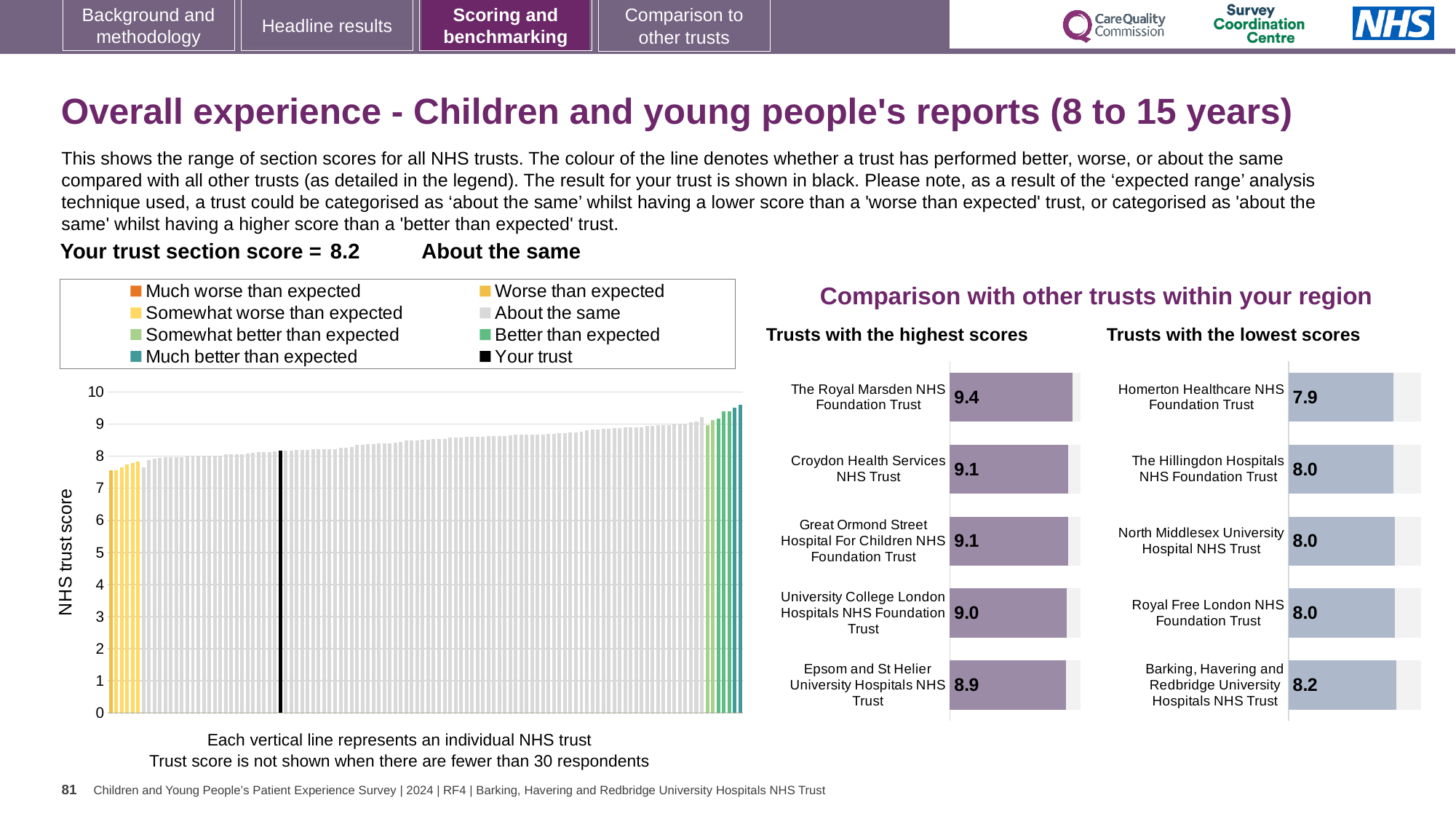
In the 'Trusts with the lowest scores' chart, what is the difference between the scores of Barking, Havering and Redbridge University Hospitals NHS Trust and Homerton Healthcare NHS Foundation Trust? 0.3 In the large chart on the left, is the value of the highest bar greater or less than 9? greater In the large chart on the left, do the trust scores rise or fall from left to right? Rise What kind of chart is the large chart on the left showing NHS trust scores? Bar chart In the 'Trusts with the highest scores' chart, how many trusts are shown? 5 In the 'Trusts with the highest scores' chart, which trust has the lowest score? Epsom and St Helier University Hospitals NHS Trust In the 'Trusts with the lowest scores' chart, what is the score for Homerton Healthcare NHS Foundation Trust? 7.9 In the 'Trusts with the highest scores' chart, what is the score for The Royal Marsden NHS Foundation Trust? 9.4 In the 'Trusts with the highest scores' chart, what is the difference between the scores of The Royal Marsden NHS Foundation Trust and Epsom and St Helier University Hospitals NHS Trust? 0.5 How many entries does the legend of the large chart on the left list? 8 In the 'Trusts with the lowest scores' chart, which trust has the highest score? Barking, Havering and Redbridge University Hospitals NHS Trust In the 'Trusts with the lowest scores' chart, which has the larger score: Barking, Havering and Redbridge University Hospitals NHS Trust or Homerton Healthcare NHS Foundation Trust? Barking, Havering and Redbridge University Hospitals NHS Trust